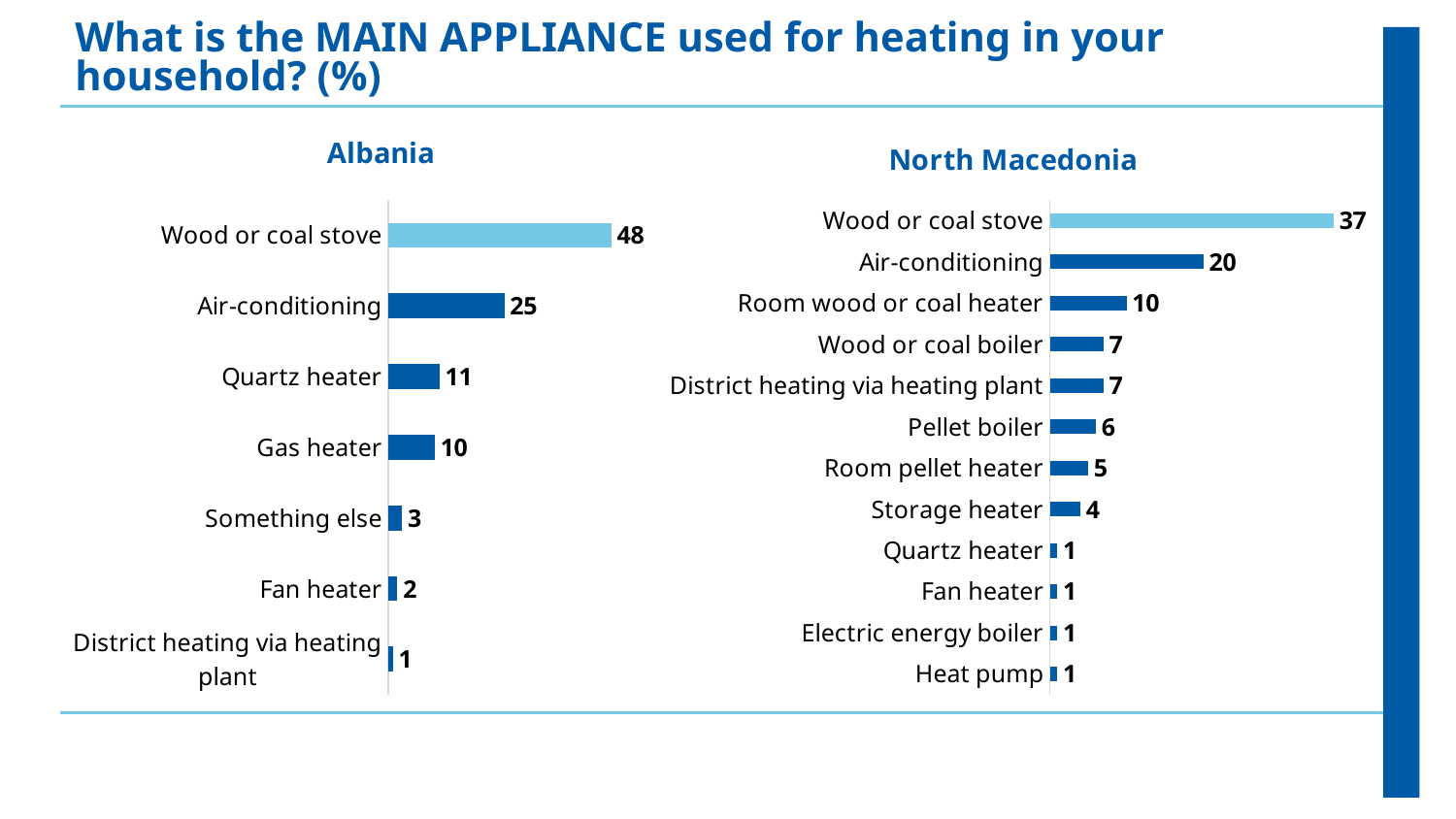
In the North Macedonia chart, which category has the highest value? Wood or coal stove In the North Macedonia chart, what is the difference between Wood or coal stove and Air-conditioning? 17 How many categories are shown in the Albania chart? 7 In the North Macedonia chart, what is the value for Room wood or coal heater? 10 In the Albania chart, which category has the lowest value? District heating via heating plant In the Albania chart, what is the difference between Wood or coal stove and Air-conditioning? 23 Which is larger: Quartz heater in the Albania chart or Quartz heater in the North Macedonia chart? Albania How many categories are shown in the North Macedonia chart? 12 In the Albania chart, what is the value for Wood or coal stove? 48 In the Albania chart, which category has the highest value? Wood or coal stove In the North Macedonia chart, what is the value for Air-conditioning? 20 What type of chart is the Albania chart? Bar chart